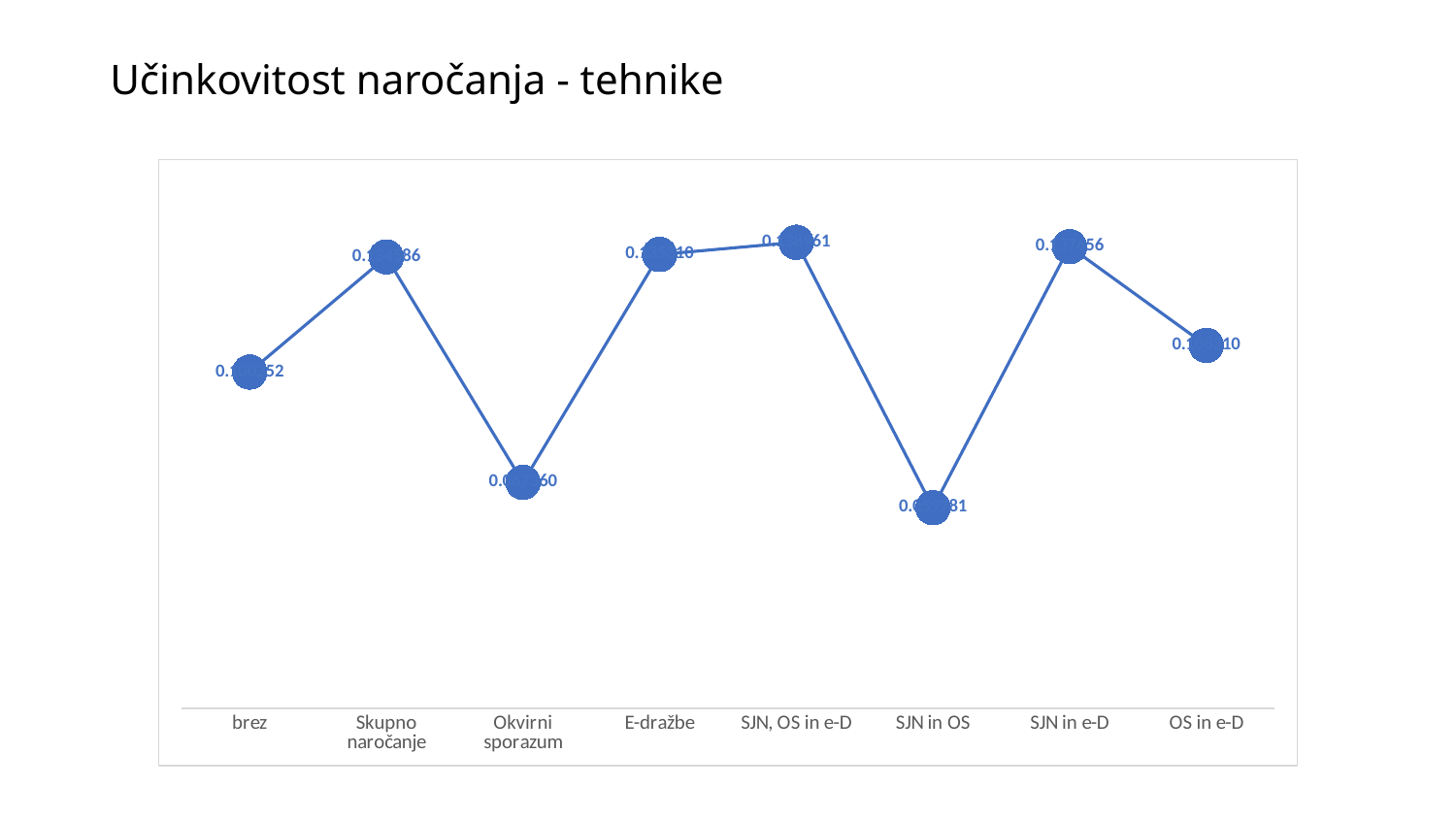
Which category has the lowest value? SJN in OS Which is higher, the value for brez or the value for Skupno naročanje? Skupno naročanje Does the line rise or fall from SJN in e-D to OS in e-D? fall What is the label of the first category on the x axis? brez Which is lower, the value for Okvirni sporazum or the value for SJN in OS? SJN in OS Which is higher, the value for brez or the value for OS in e-D? OS in e-D What kind of chart is shown on the slide? line chart How many categories are plotted along the x axis? 8 What is the title of the slide? Učinkovitost naročanja - tehnike Does the line rise or fall from brez to Skupno naročanje? rise